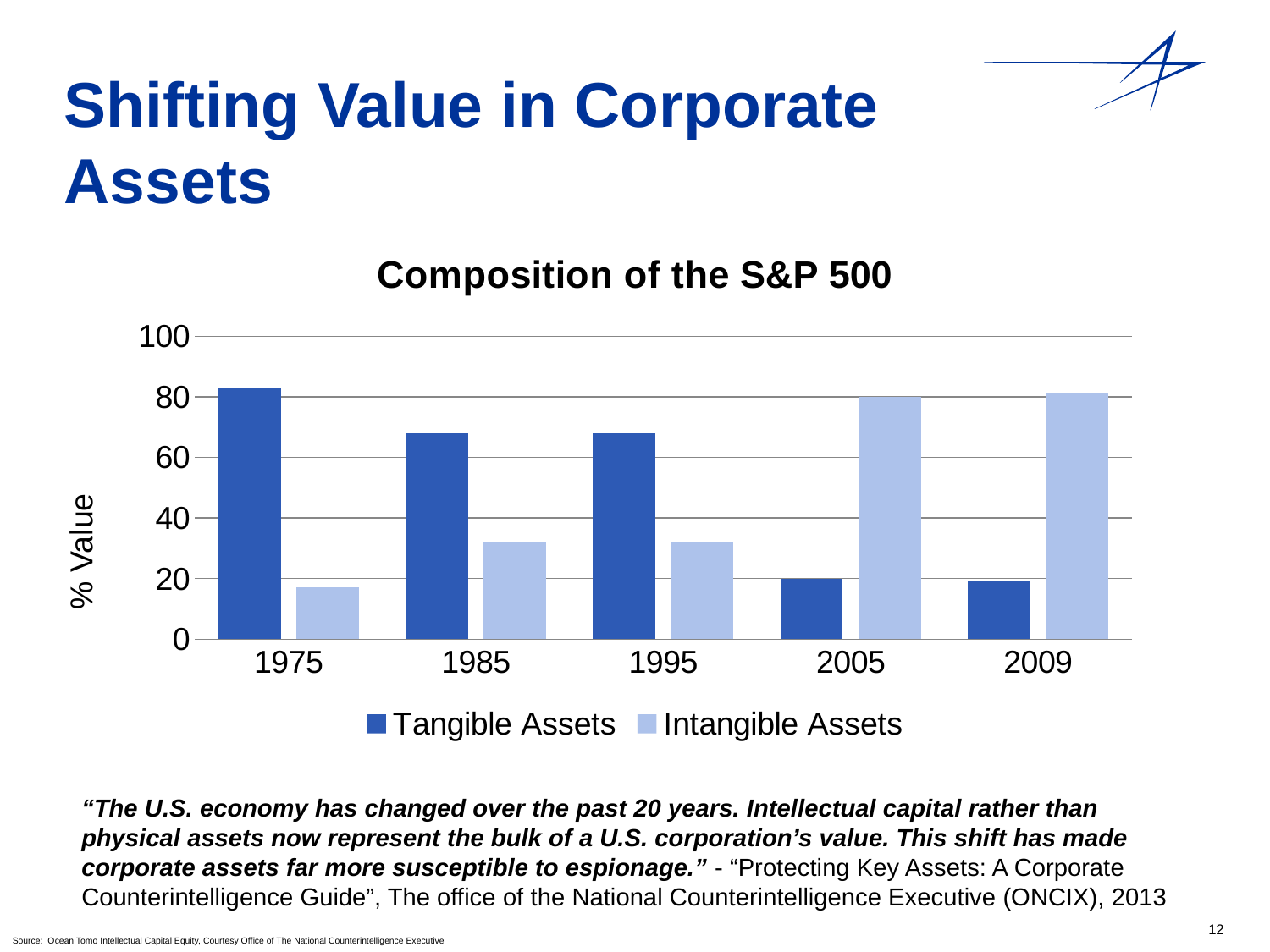
In which year is the Intangible Assets value lowest? 1975 What is the title of the chart? Composition of the S&P 500 In 1995, which is larger: Tangible Assets or Intangible Assets? Tangible Assets Does the Tangible Assets value rise or fall from 1975 to 2009? fall Is the Tangible Assets value for 2009 greater or less than 40? less What kind of chart is shown on the slide? bar chart How many years are shown on the x axis? 5 Is the Intangible Assets value for 2005 greater or less than 60? greater Is the Intangible Assets value for 1975 greater or less than 20? less How many series does the legend list? 2 In which year is the Tangible Assets value highest? 1975